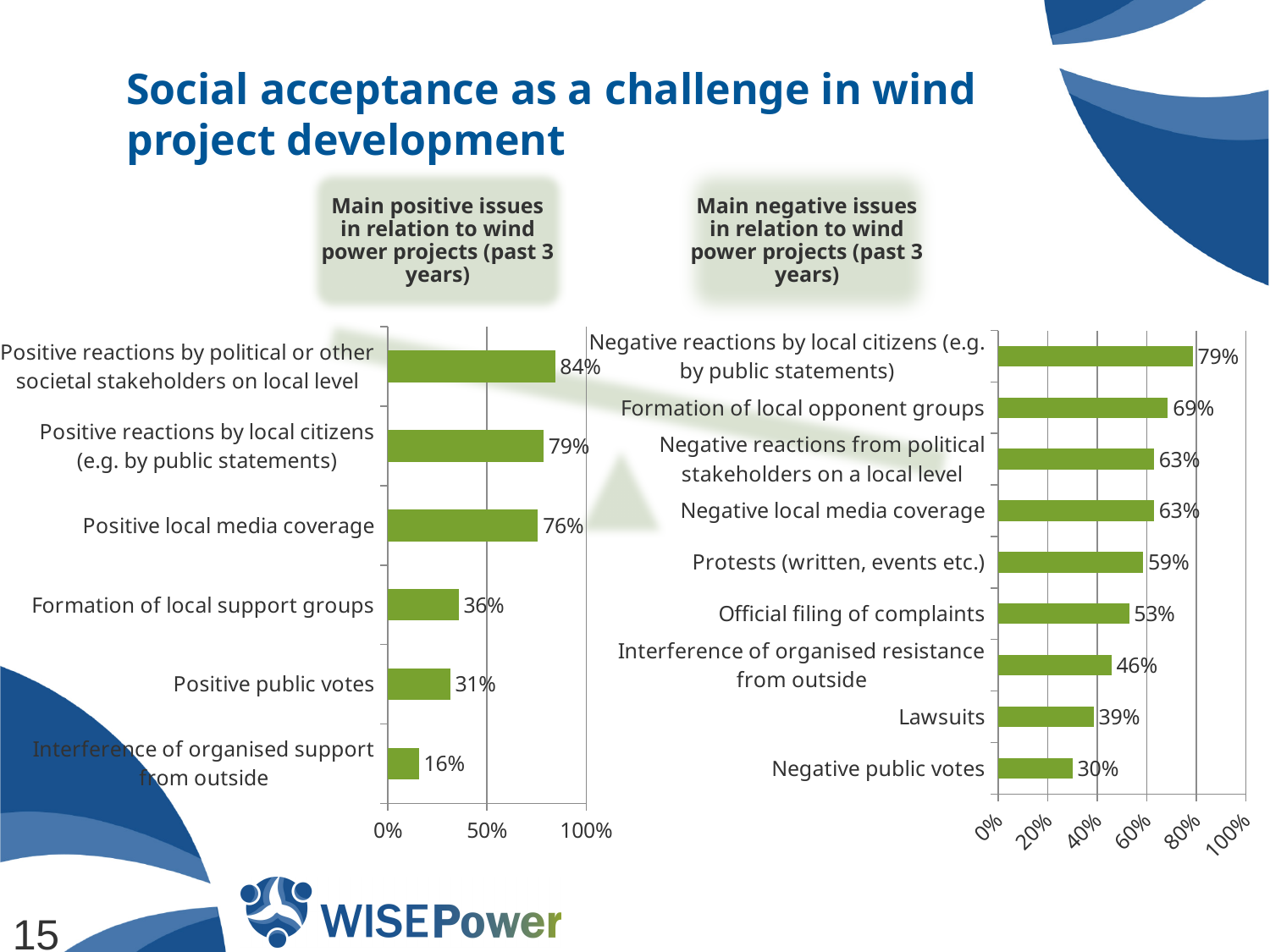
In the 'Main negative issues' chart on the right, what is the difference between Formation of local opponent groups and Official filing of complaints? 16% How many categories are shown in the 'Main positive issues' chart on the left? 6 In the 'Main positive issues' chart on the left, what is the value for Interference of organised support from outside? 16% In the 'Main negative issues' chart on the right, which category has the lowest value? Negative public votes In the 'Main positive issues' chart on the left, which category has the highest value? Positive reactions by political or other societal stakeholders on local level In the 'Main positive issues' chart on the left, what is the value for Positive local media coverage? 76% In the 'Main negative issues' chart on the right, which is larger: Protests (written, events etc.) or Interference of organised resistance from outside? Protests (written, events etc.) In the 'Main positive issues' chart on the left, what is the difference between Positive reactions by local citizens and Formation of local support groups? 43% How many categories are shown in the 'Main negative issues' chart on the right? 9 What type of chart is the 'Main negative issues' chart on the right? Bar chart In the 'Main negative issues' chart on the right, what is the value for Lawsuits? 39% In the 'Main positive issues' chart on the left, is the value for Positive public votes greater or less than 50%? less